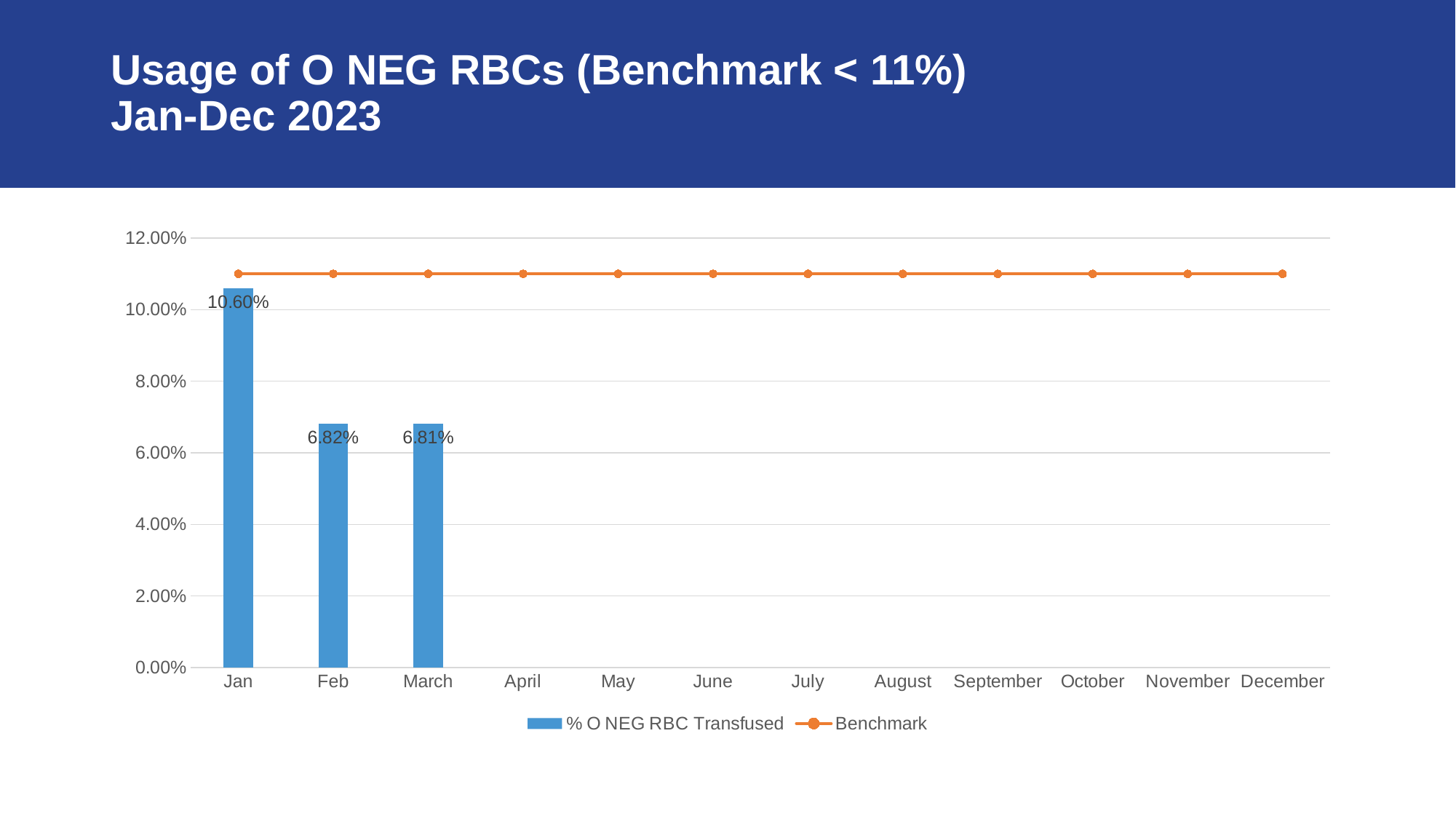
What is the % O NEG RBC Transfused value for Jan? 10.60% How many series does the legend list? 2 What benchmark does the chart title state for O NEG RBC usage? < 11% Is the % O NEG RBC Transfused value for Jan greater or less than 10.00%? greater How many months are shown on the x axis? 12 Which is larger, the % O NEG RBC Transfused value for Jan or for March? Jan What is the % O NEG RBC Transfused value for Feb? 6.82% What is the % O NEG RBC Transfused value for March? 6.81% Which month has the highest % O NEG RBC Transfused value? Jan What is the difference between the Jan and Feb % O NEG RBC Transfused values? 3.78% Is the % O NEG RBC Transfused value for Feb greater or less than 8.00%? less How many months have a plotted % O NEG RBC Transfused bar? 3